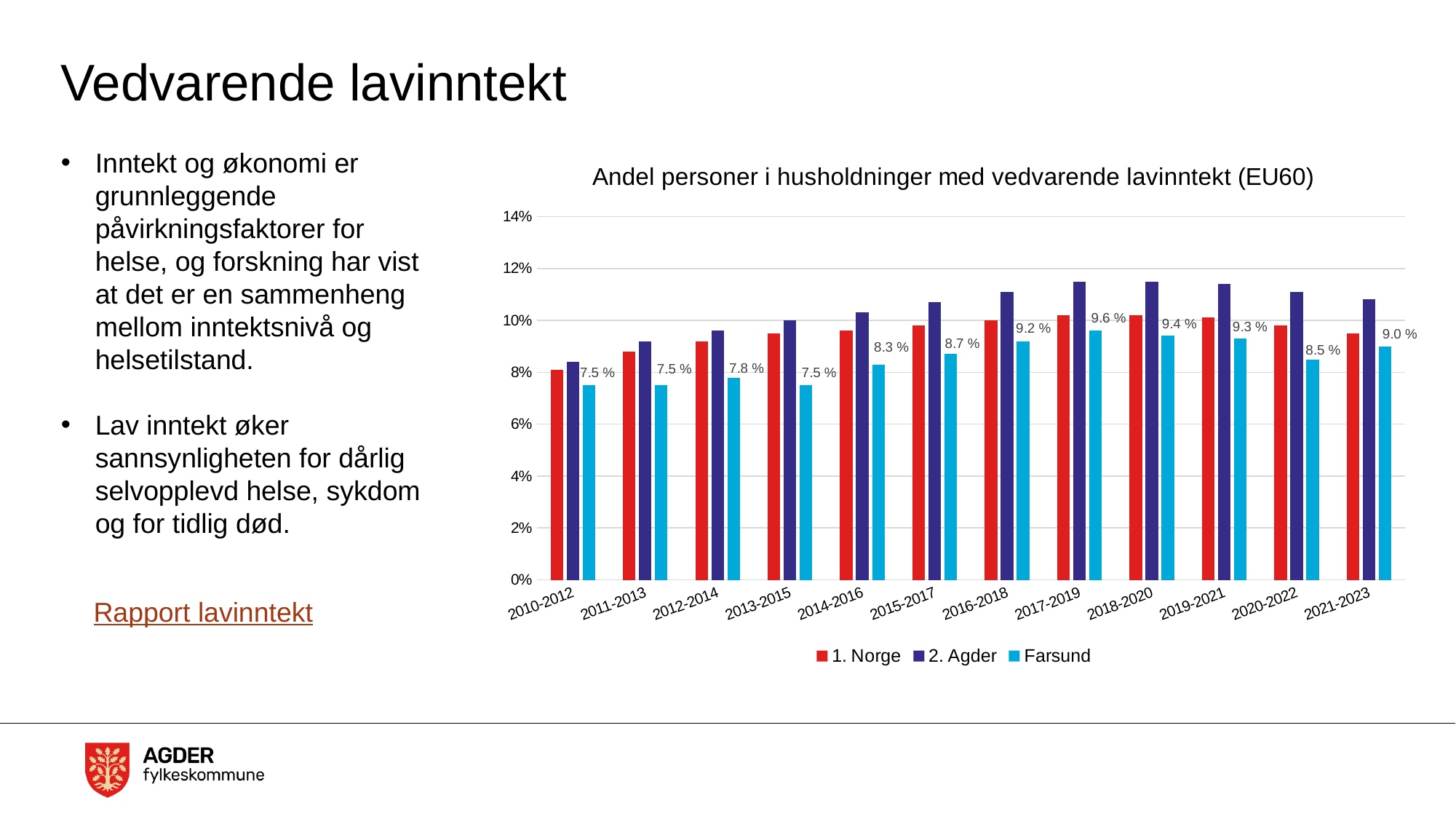
Is the value for 2. Agder in 2017-2019 greater or less than 10%? greater In which period is the Farsund value highest? 2017-2019 What type of chart is shown on the slide? Bar chart How many series does the chart legend list? 3 What is the value for Farsund in 2017-2019? 9.6 % In 2017-2019, which is larger: the value for 2. Agder or the value for Farsund? 2. Agder What is the difference between the Farsund value in 2017-2019 and in 2010-2012? 2.1 percentage points What is the title of the chart? Andel personer i husholdninger med vedvarende lavinntekt (EU60) How many time periods are shown on the x axis of the chart? 12 What is the value for Farsund in 2021-2023? 9.0 % What is the value for Farsund in 2014-2016? 8.3 % What is the lowest value shown for Farsund? 7.5 %